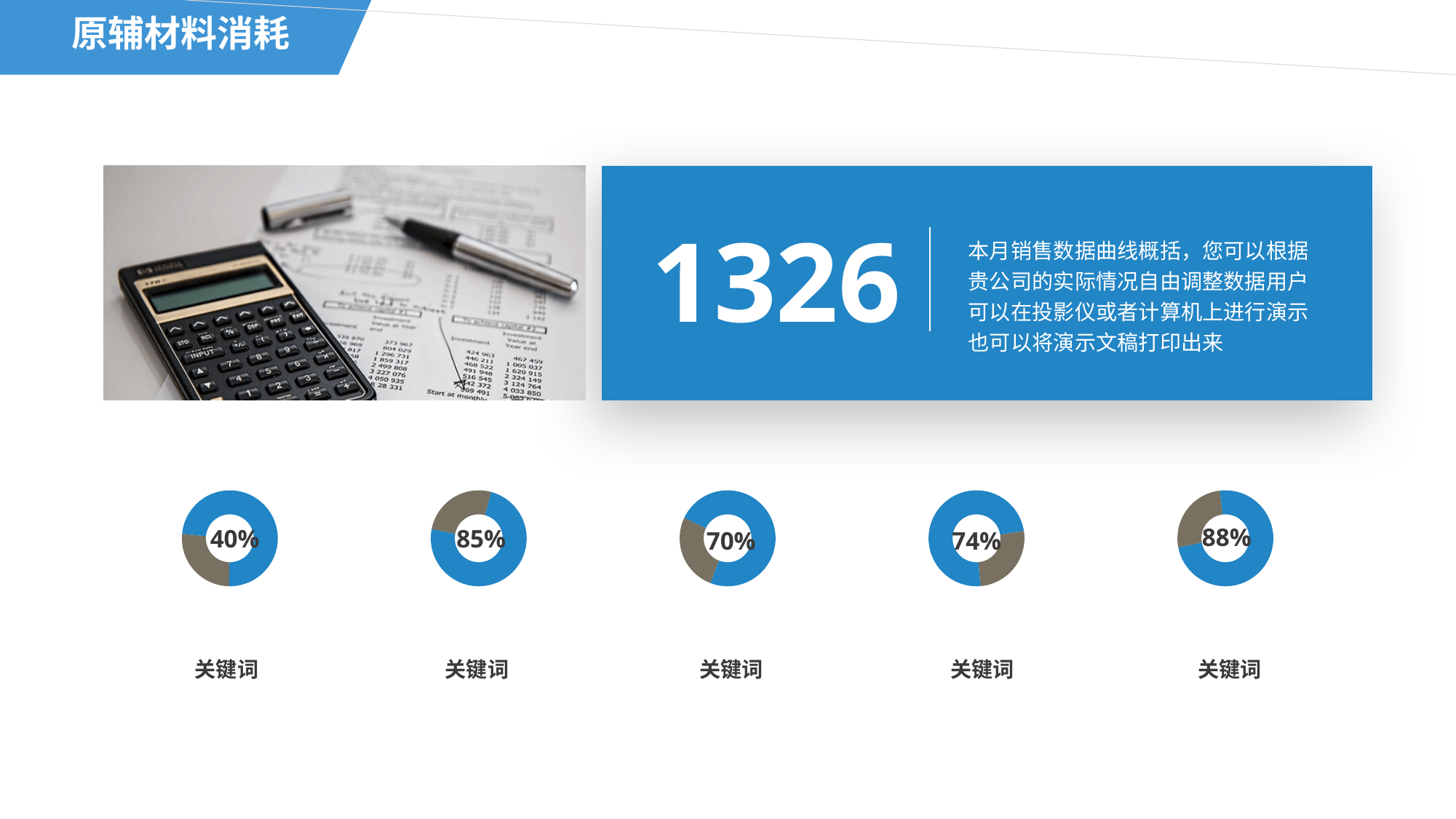
What is the difference between the highest and lowest percentages shown in the donut charts? 48 percentage points What percentage is shown in the first (leftmost) donut chart? 40% What kind of charts are shown at the bottom of the slide? Donut (pie) charts What percentage is shown in the second donut chart from the left? 85% What percentage is shown in the fourth donut chart from the left? 74% What is the title of the slide? 原辅材料消耗 Which donut chart shows the lowest percentage? The leftmost one (40%) Which donut chart shows the highest percentage? The rightmost one (88%) What percentage is shown in the rightmost donut chart? 88% How many donut charts are on the slide? 5 Which is larger: the percentage in the second donut chart or the percentage in the fourth donut chart? The second (85%) What percentage is shown in the middle (third) donut chart? 70%